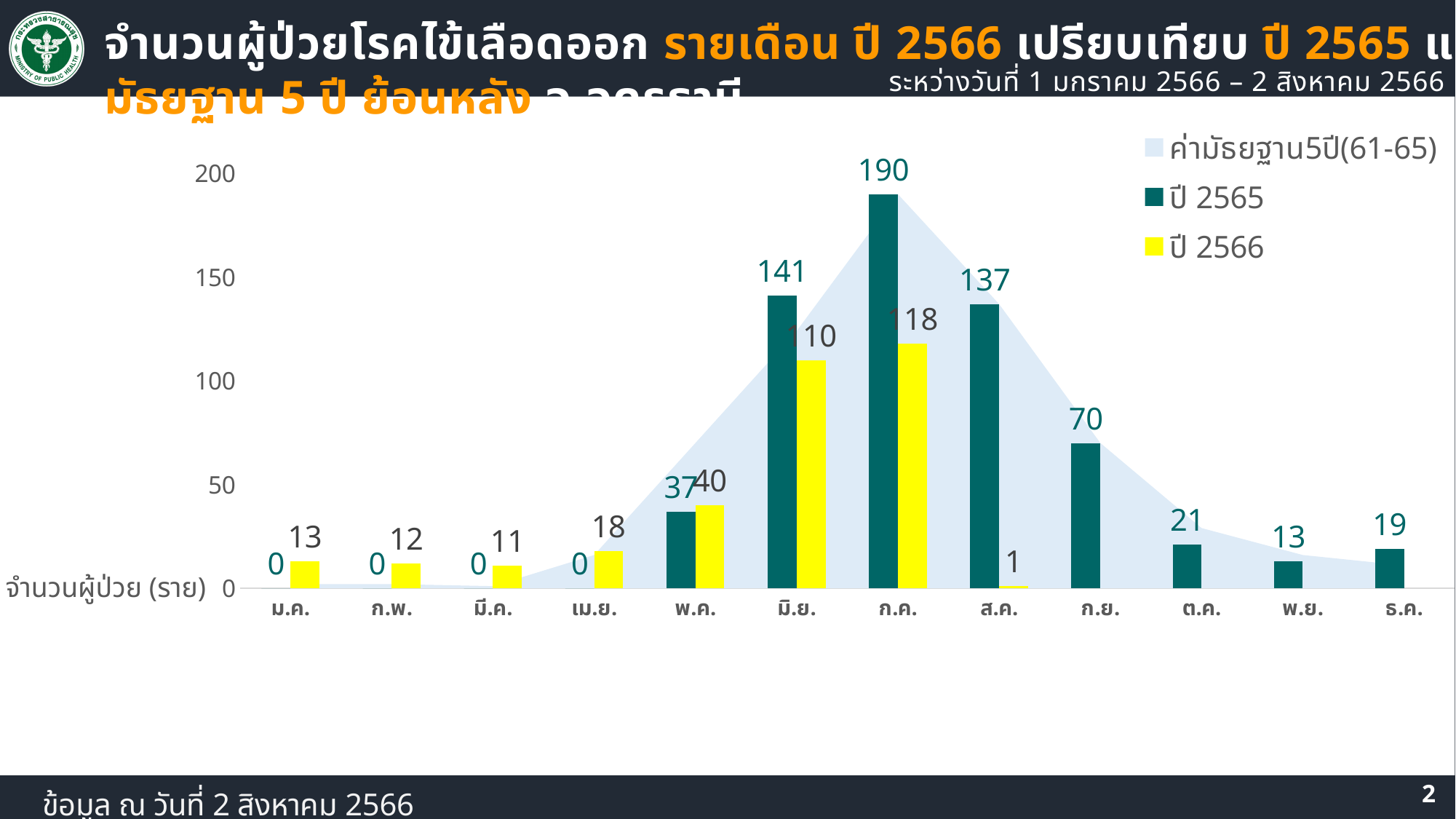
How many months are shown on the x axis? 12 How many series does the legend list? 3 What is the difference between ปี 2565 in มิ.ย. and ปี 2565 in ส.ค.? 4 Which month has the highest value for ปี 2566? ก.ค. What is the value for ปี 2565 in ก.ค.? 190 What is the difference between ปี 2565 and ปี 2566 in ก.ค.? 72 What is the value for ปี 2566 in มิ.ย.? 110 Which is larger in พ.ค., the value for ปี 2565 or ปี 2566? ปี 2566 Which month has the highest value for ปี 2565? ก.ค. What is the value for ปี 2566 in ม.ค.? 13 What kind of chart is used for the ปี 2565 and ปี 2566 series? bar chart What colour are the bars for ปี 2566? yellow